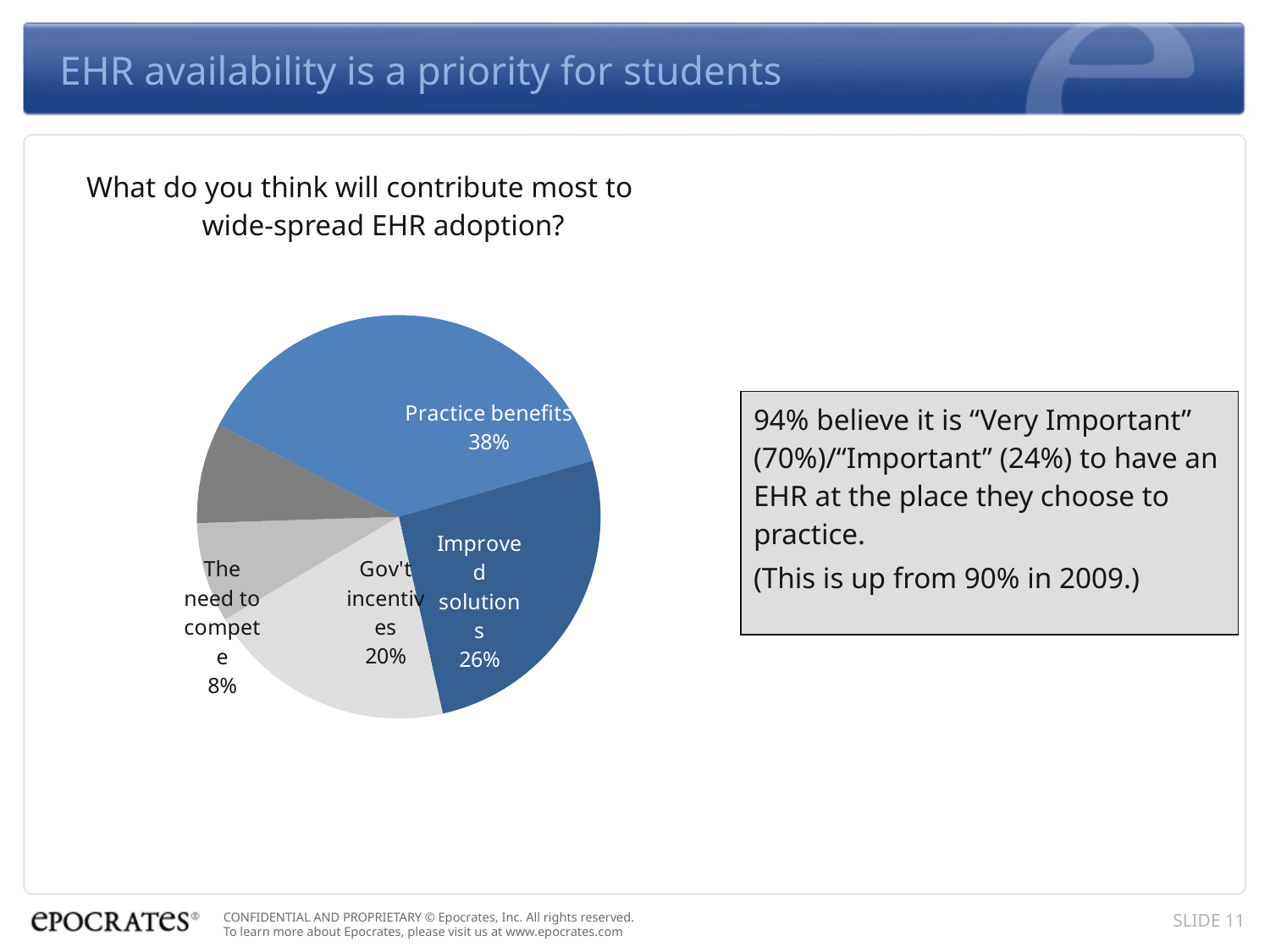
Which slice is larger, Improved solutions or Gov't incentives? Improved solutions What percentage of the pie is the Practice benefits slice? 38% What share of the pie do the Practice benefits and Improved solutions slices make up together? 64% What is the title of the chart? What do you think will contribute most to wide-spread EHR adoption? Which slice is larger, Practice benefits or Gov't incentives? Practice benefits What percentage of the pie is The need to compete slice? 8% What percentage of the pie is the Gov't incentives slice? 20% What is the difference in percentage points between the Gov't incentives slice and The need to compete slice? 12 What is the difference in percentage points between the Practice benefits slice and the Improved solutions slice? 12 What percentage of the pie is the Improved solutions slice? 26% Which labeled slice of the pie is the largest? Practice benefits What kind of chart is shown on the slide? pie chart